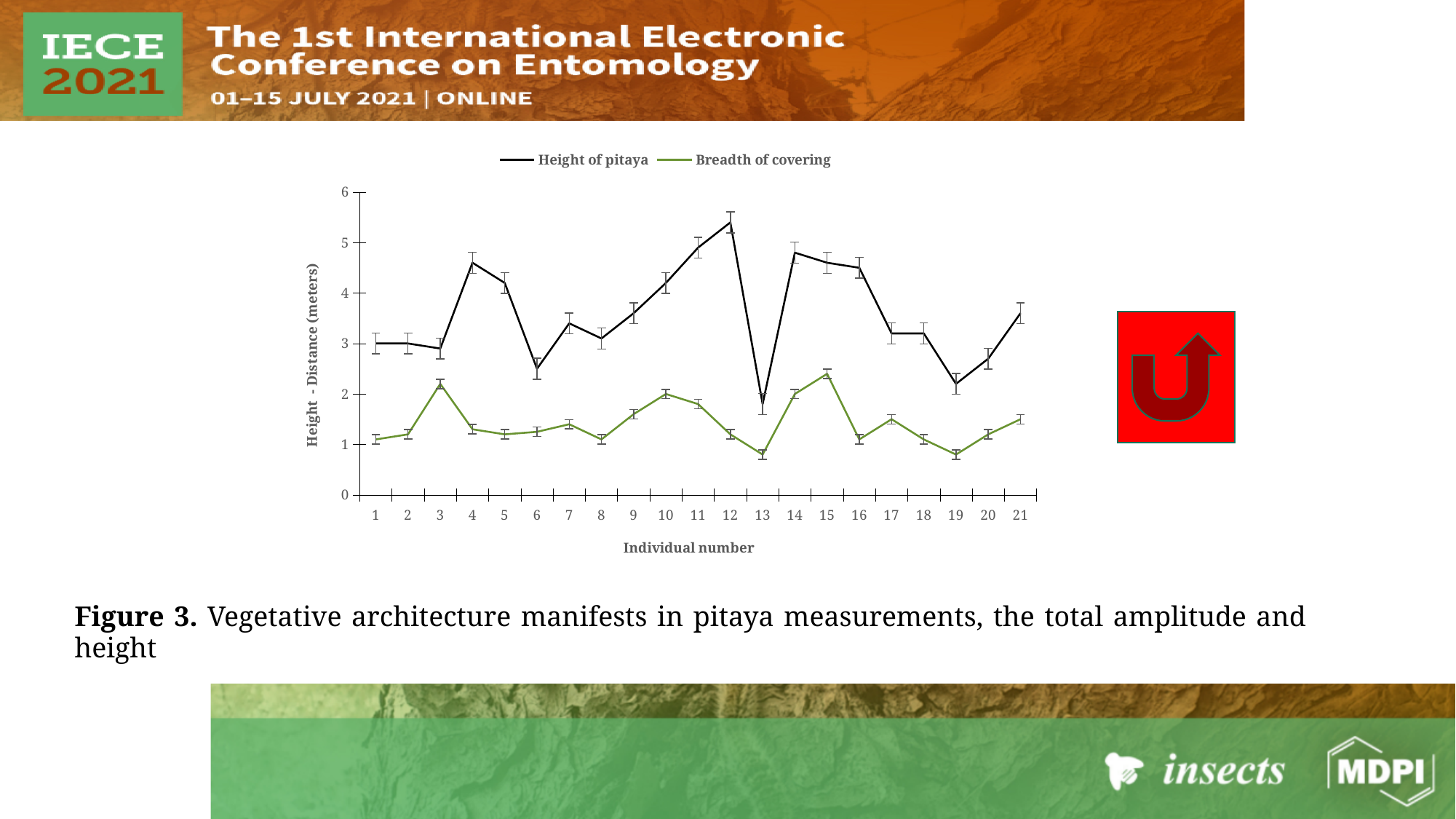
What is the title of the y axis? Height - Distance (meters) Is the Height of pitaya for individual 13 greater or less than 2? less Is the Height of pitaya for individual 6 greater or less than 3? less Is the Breadth of covering for individual 15 greater or less than 2? greater How many series does the legend list? 2 What kind of chart is shown on the slide? line chart How many individuals are plotted along the x axis? 21 Does the Height of pitaya rise or fall from individual 6 to individual 12? rise Which individual number has the lowest Height of pitaya? 13 Which individual number has the highest Height of pitaya? 12 Which is larger, the Height of pitaya for individual 4 or for individual 5? individual 4